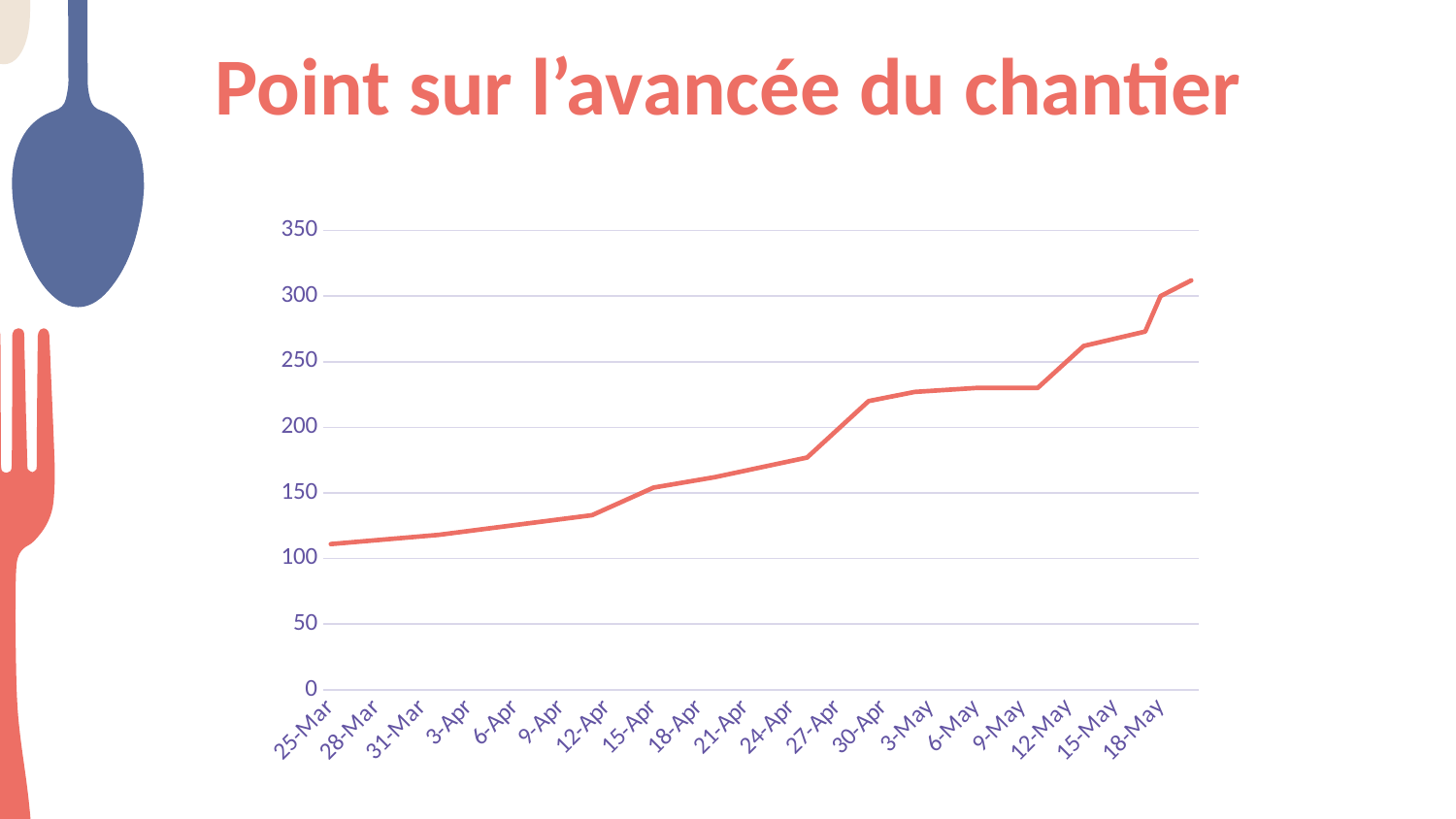
What kind of chart is shown on the slide? line chart Is the value for 18-May greater or less than 250? greater Is the value for 3-May greater or less than 250? less Which date label on the x axis has the highest value? 18-May Which date label on the x axis has the lowest value? 25-Mar Is the value for 25-Mar greater or less than 100? greater Which is larger, the value for 27-Apr or the value for 3-Apr? 27-Apr Do the values rise or fall along the x axis from 25-Mar to 18-May? rise What is the title of the slide containing the chart? Point sur l’avancée du chantier